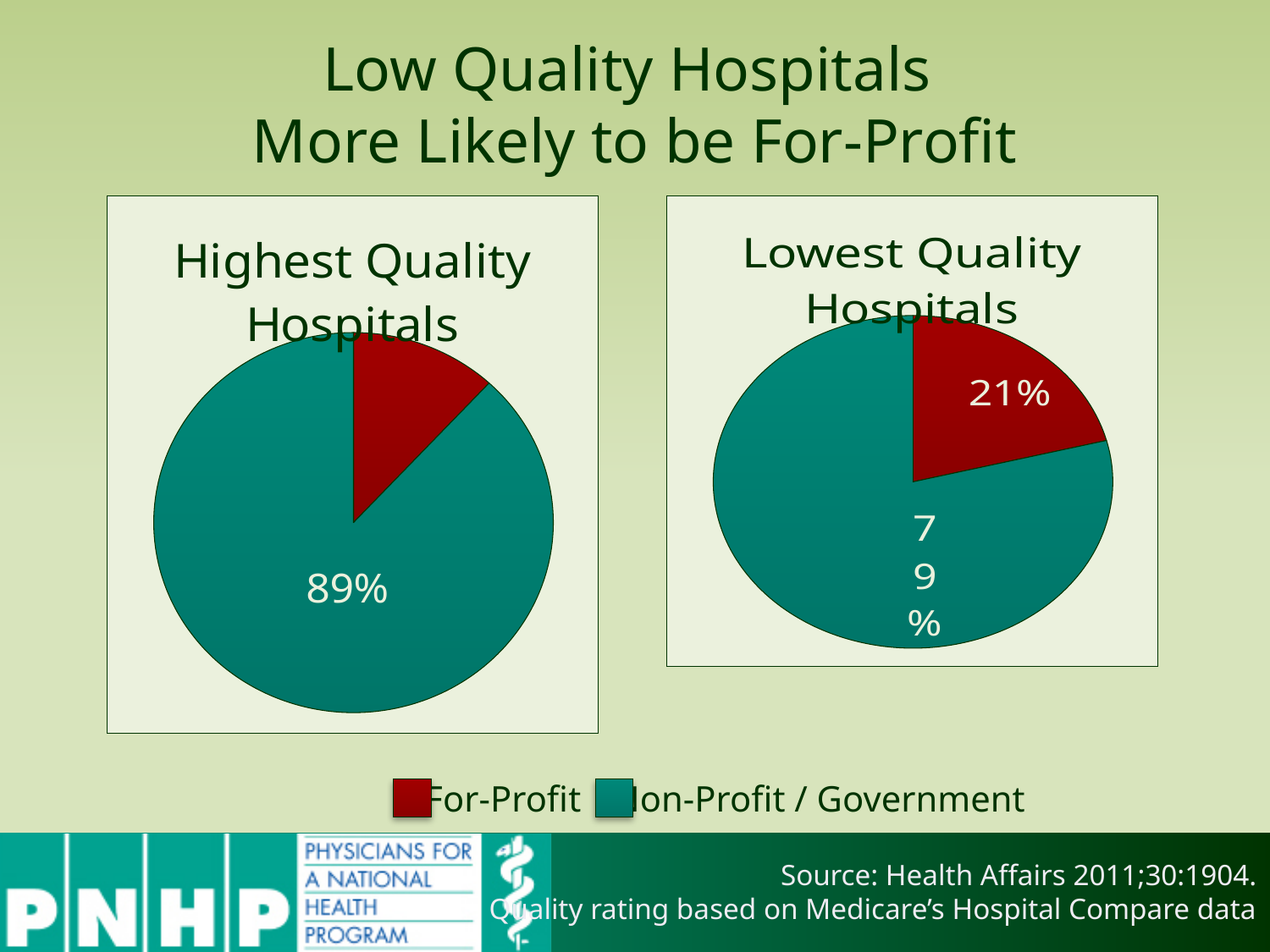
In the Lowest Quality Hospitals chart, which category has the largest slice? Non-Profit / Government Which chart has the larger For-Profit slice, Highest Quality Hospitals or Lowest Quality Hospitals? Lowest Quality Hospitals In the Highest Quality Hospitals chart, what share is Non-Profit / Government? 89% In the Lowest Quality Hospitals chart, what share is For-Profit? 21% What colour represents For-Profit in the legend? Red In the Lowest Quality Hospitals chart, what share is Non-Profit / Government? 79% What is the title of the slide? Low Quality Hospitals More Likely to be For-Profit In the Lowest Quality Hospitals chart, what is the difference in percentage points between the Non-Profit / Government share and the For-Profit share? 58 percentage points How many categories does the legend list? 2 How many slices does each pie chart have? 2 In the Highest Quality Hospitals chart, which category has the smallest slice? For-Profit What type of charts are shown on the slide? Pie charts